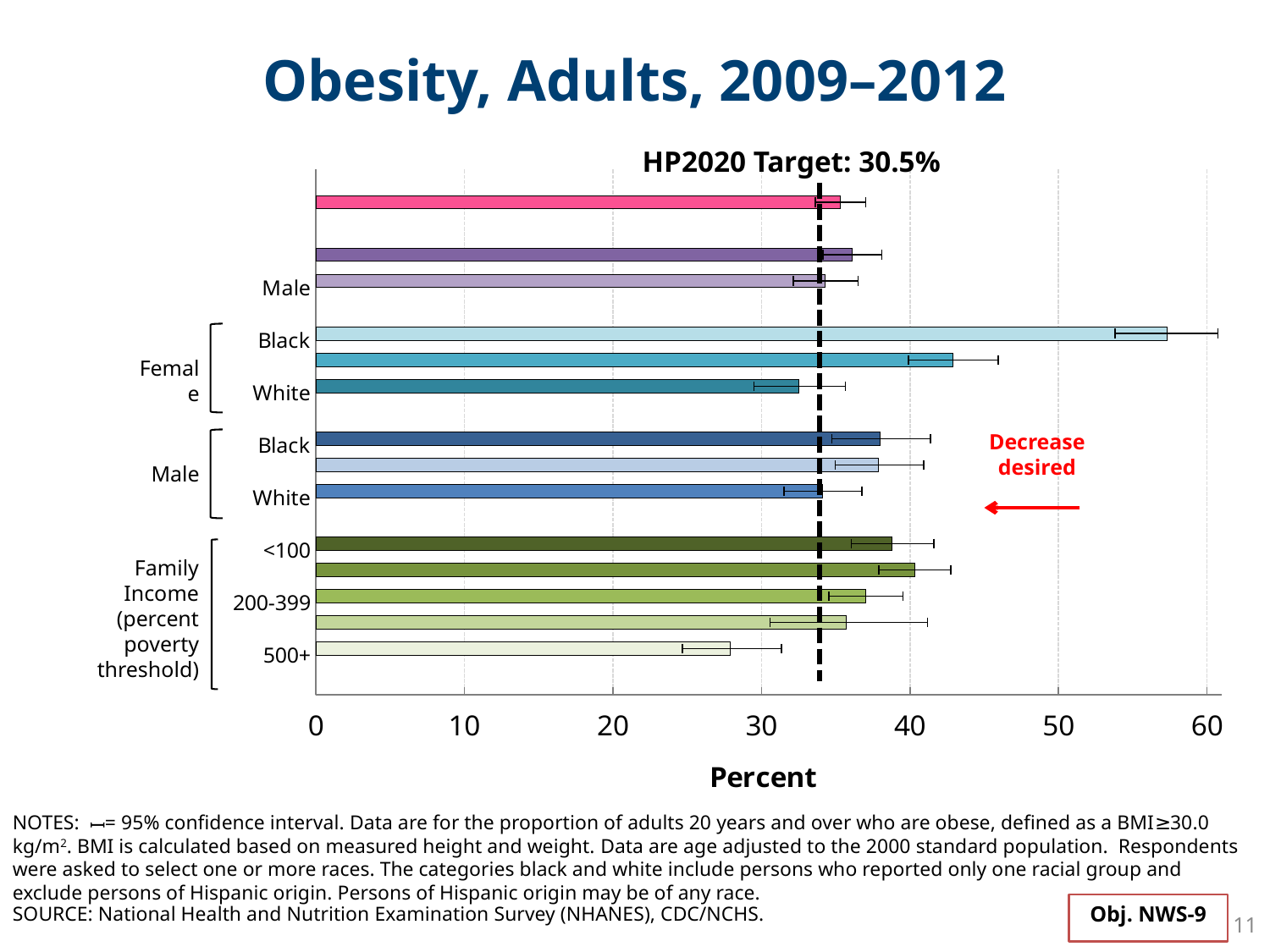
Is the value for Female Black greater or less than 50? greater Which is larger, the value for Female Black or the value for Male Black? Female Black Is the value for Female White greater or less than 40? less Which is larger, the value for the <100 family income group or the 500+ family income group? <100 Which category has the lowest obesity percentage? 500+ (Family Income) Is the value for Male White greater or less than 30? greater What kind of chart is shown on the slide? bar chart What is the HP2020 Target value shown on the chart? 30.5% Which category has the highest obesity percentage? Female Black What is the title of the chart? Obesity, Adults, 2009–2012